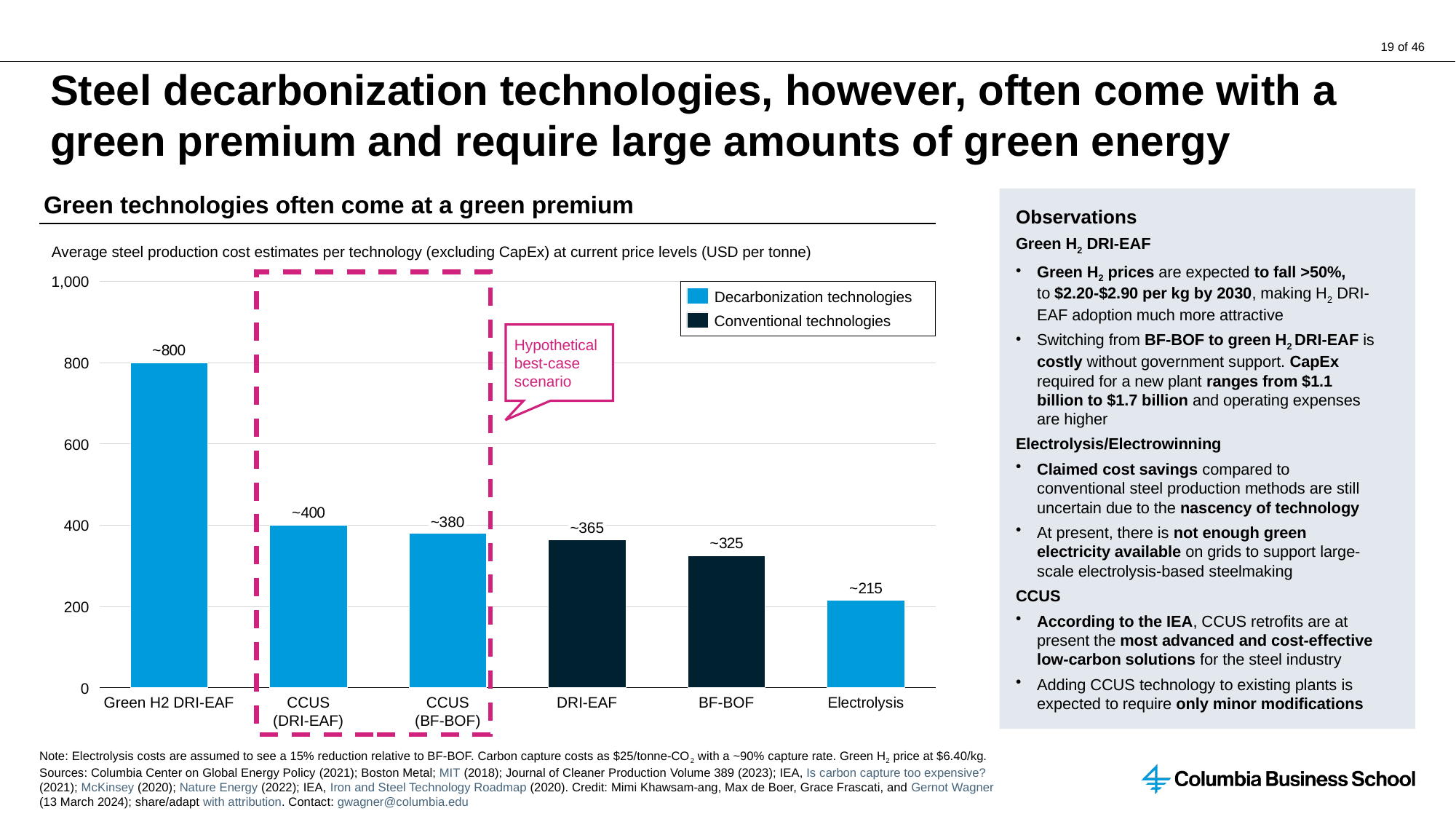
What is the labelled production cost for Green H2 DRI-EAF? ~800 Which technology has the highest average steel production cost in the chart? Green H2 DRI-EAF Which has the higher production cost, DRI-EAF or BF-BOF? DRI-EAF Which two bars are enclosed by the dashed box labelled 'Hypothetical best-case scenario'? CCUS (DRI-EAF) and CCUS (BF-BOF) Which technology has the lowest average steel production cost in the chart? Electrolysis How many technologies (categories) are plotted on the x axis of the chart? 6 How many series does the chart legend list? 2 What kind of chart is shown on the slide? bar chart Is the value for Green H2 DRI-EAF greater or less than 600? greater What is the labelled production cost for CCUS (DRI-EAF)? ~400 What is the labelled production cost for BF-BOF? ~325 Is the value for Electrolysis greater or less than 400? less